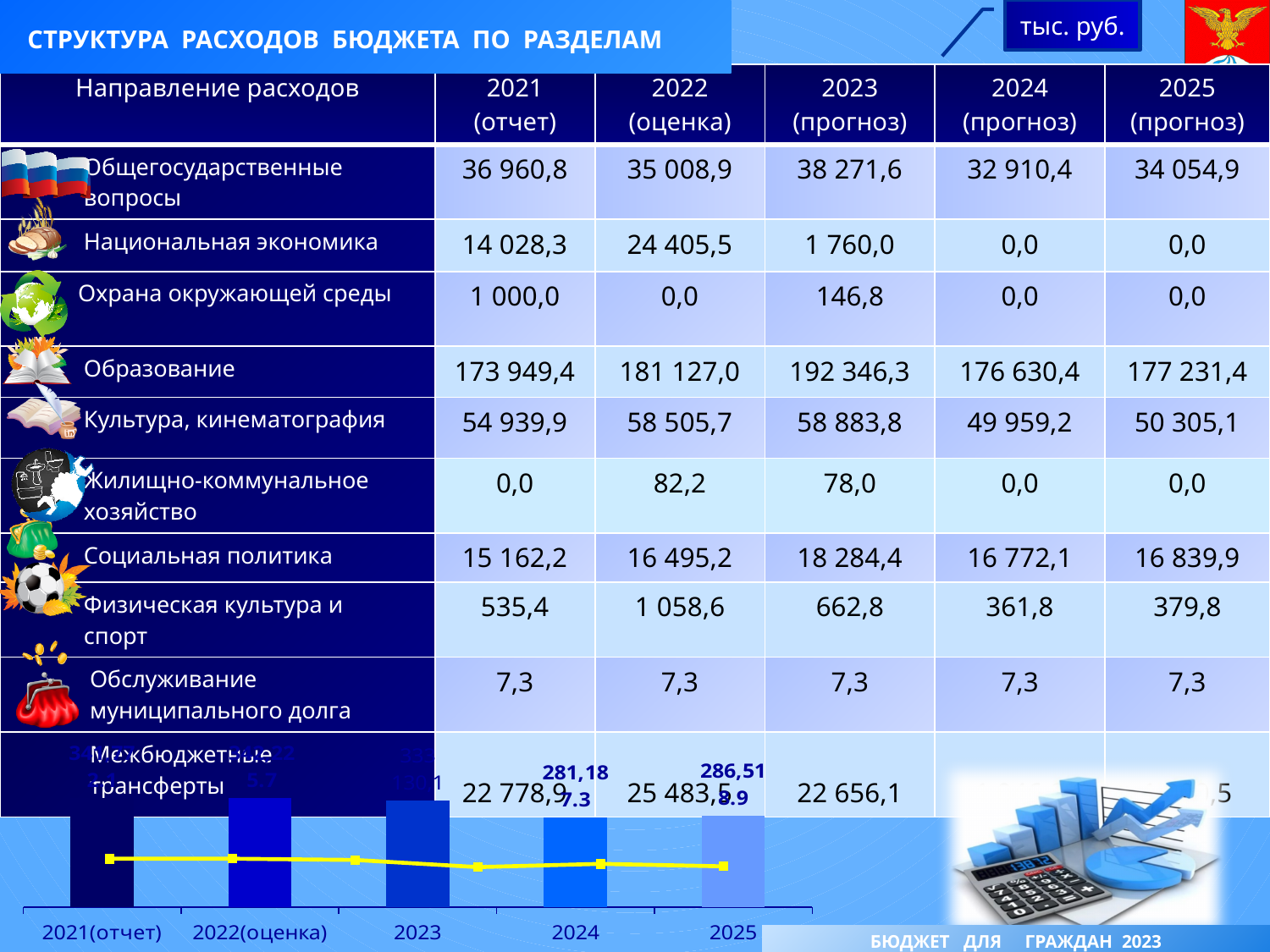
In the chart at the bottom of the slide, what data label is shown above the bar for 2024? 281,187.3 What is the first category on the x axis of the chart at the bottom of the slide? 2021(отчет) In the chart at the bottom of the slide, what data label is shown above the bar for 2025? 286,518.9 What kind of chart is shown at the bottom of the slide? bar chart with a line In the chart at the bottom of the slide, which bar has the larger labelled value, 2024 or 2025? 2025 What is the last category on the x axis of the chart at the bottom of the slide? 2025 How many categories are shown on the x axis of the chart at the bottom of the slide? 5